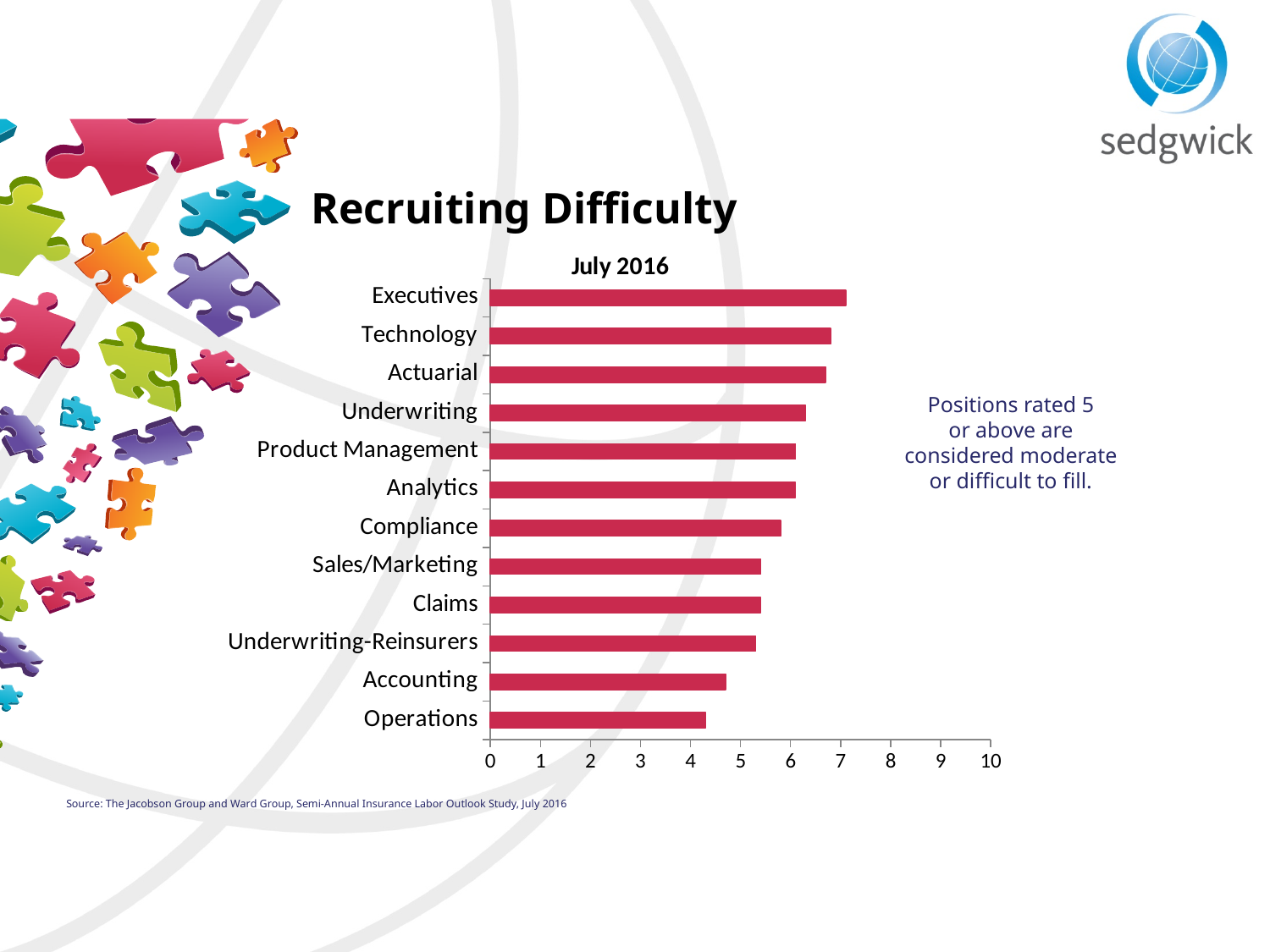
Is the value for Operations greater or less than 5? less How many positions are listed in the chart? 12 Which position has the highest recruiting difficulty rating? Executives What is the title shown above the chart? July 2016 Is the value for Technology greater or less than 6? greater Is the value for Compliance greater or less than 5? greater What kind of chart is shown on the slide? bar chart Which has a higher value, Actuarial or Accounting? Actuarial Which position has the lowest recruiting difficulty rating? Operations Which has a higher value, Underwriting or Operations? Underwriting